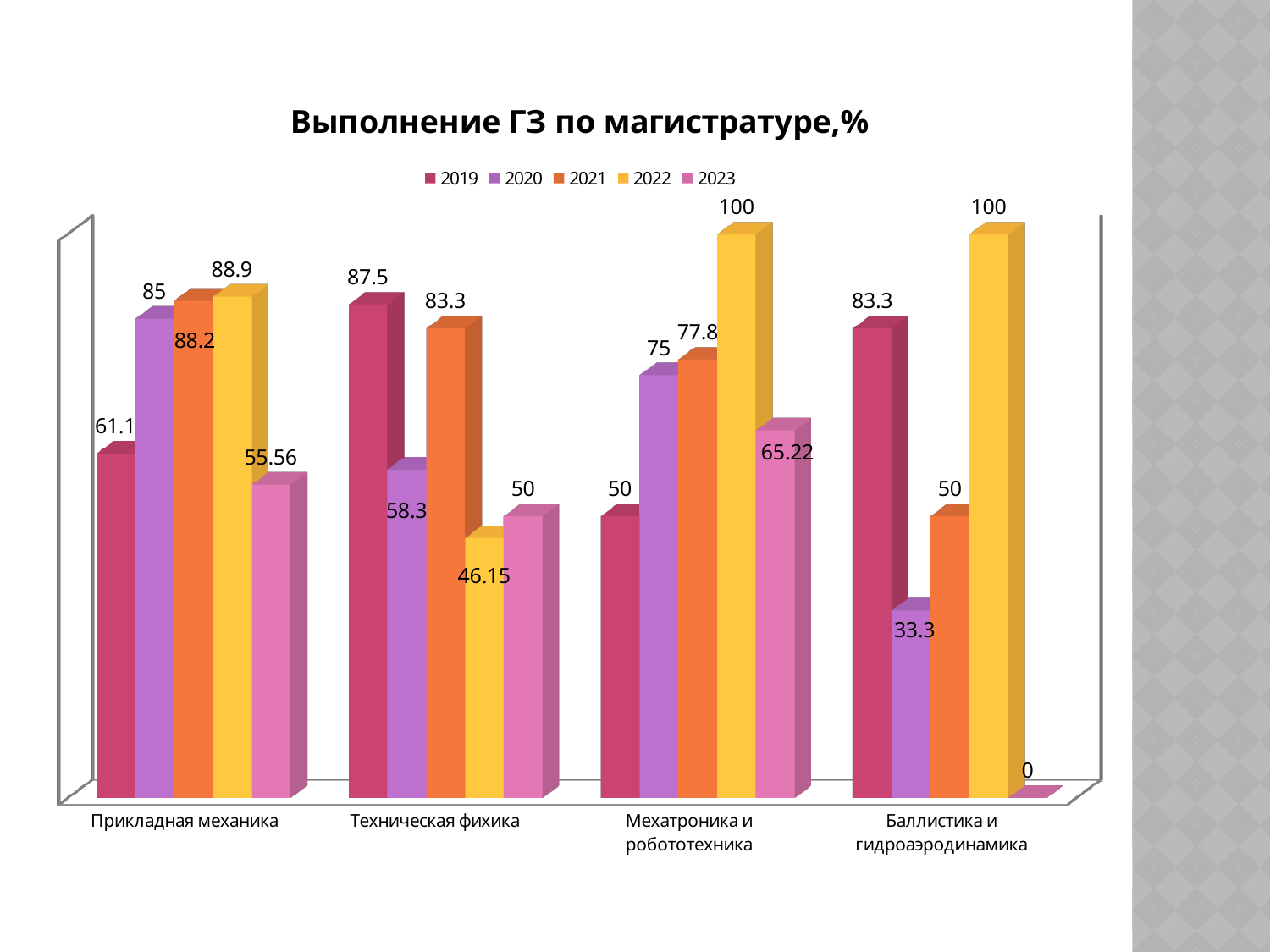
Which year has the highest value in the Баллистика и гидроаэродинамика category? 2022 What kind of chart is shown on the slide? Bar chart What is the value for 2019 in the Прикладная механика category? 61.1 What is the difference between the 2022 and 2023 values for Мехатроника и робототехника? 34.78 Which is larger for Прикладная механика: the 2020 value or the 2021 value? 2021 What is the value for 2022 in the Техническая фихика category? 46.15 Which year has the lowest value in the Техническая фихика category? 2022 What is the value for 2023 in the Мехатроника и робототехника category? 65.22 How many categories are shown on the x axis? 4 What is the title of the chart? Выполнение ГЗ по магистратуре,% How many series does the legend list? 5 What is the value for 2023 in the Баллистика и гидроаэродинамика category? 0